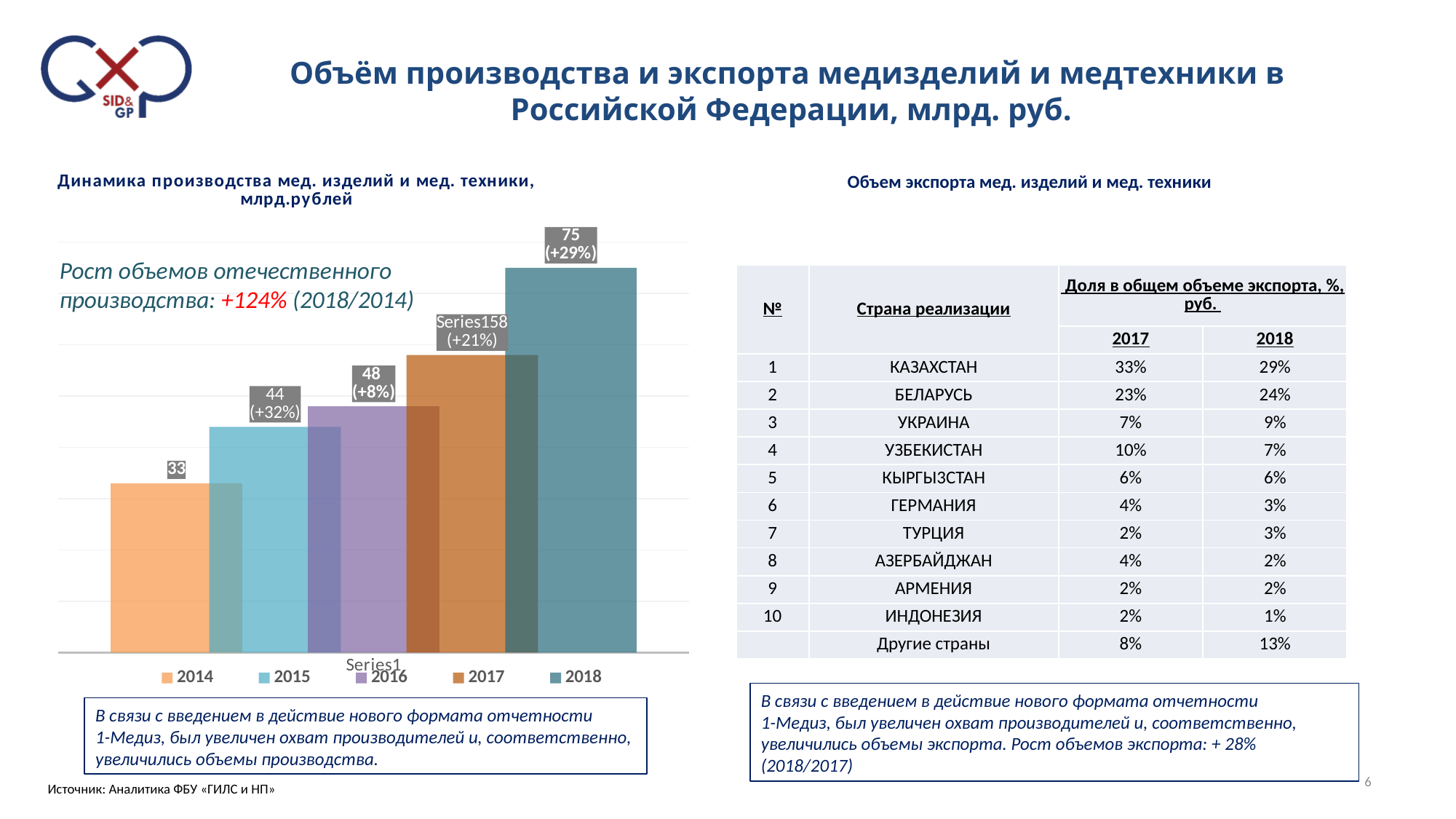
In the bar chart, which year has the highest value? 2018 In the bar chart, which is larger: the value for 2015 or the value for 2016? 2016 In the bar chart, do the values rise or fall from 2014 to 2018? rise In the bar chart, what is the value for 2014? 33 In the bar chart, what is the value for 2016? 48 In the bar chart, which year has the lowest value? 2014 In the bar chart, what is the value for 2018? 75 In the bar chart, what is the value for 2015? 44 In the bar chart, what is the difference between the values for 2018 and 2014? 42 In the bar chart, what percentage growth is shown in the data label for 2018? +29% What kind of chart is shown on the left of the slide under the title "Динамика производства мед. изделий и мед. техники, млрд.рублей"? bar chart How many series does the legend of the bar chart list? 5